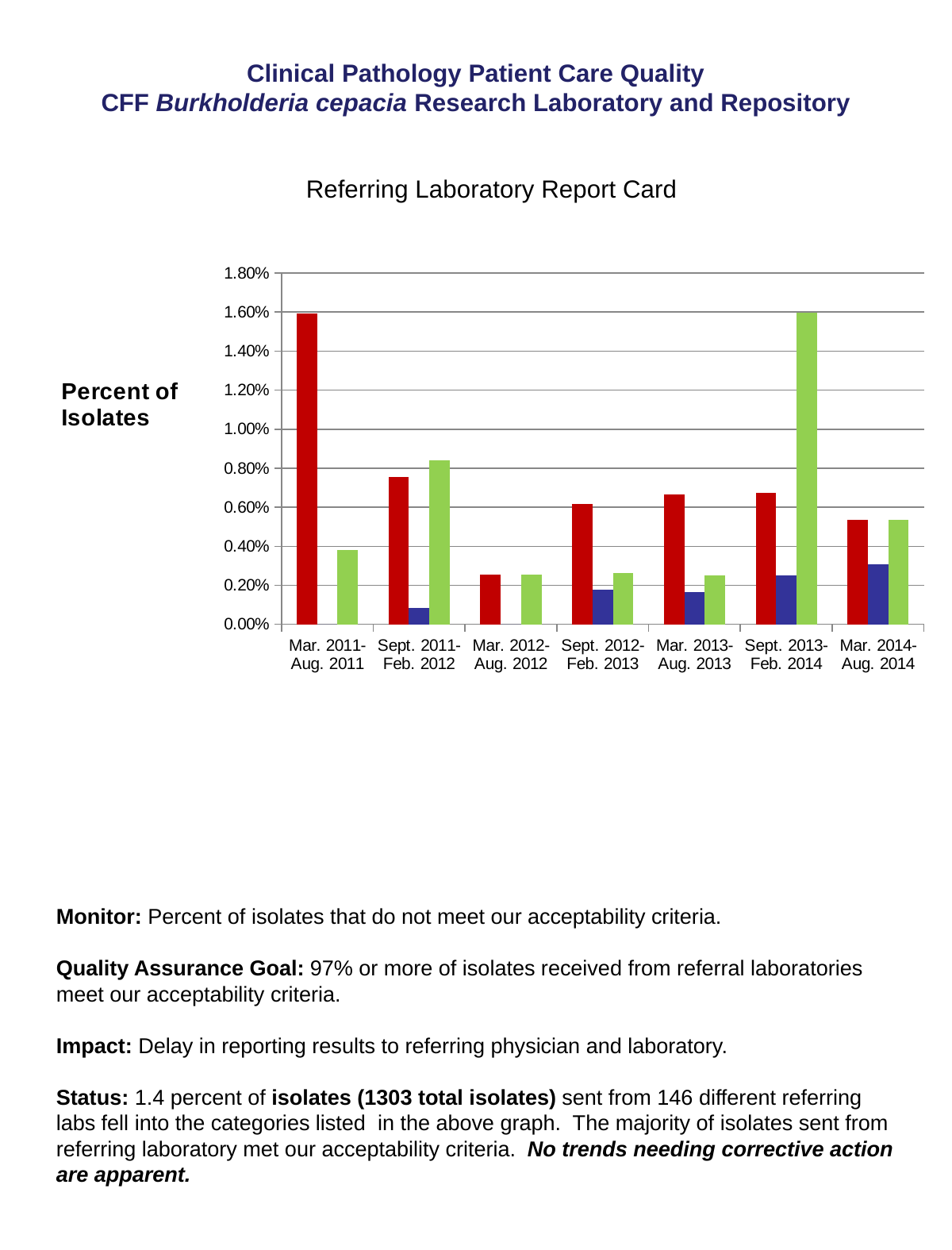
What is the title of the chart? Referring Laboratory Report Card Is the value of the red bar for Sept. 2011-Feb. 2012 greater or less than 0.60%? greater Is the value of the red bar for Mar. 2011-Aug. 2011 greater or less than 1.40%? greater Is the value of the green bar for Sept. 2013-Feb. 2014 greater or less than 1.40%? greater How many time periods are shown along the x axis of the chart? 7 In which period is the red bar the tallest? Mar. 2011-Aug. 2011 In which period is the red bar the shortest? Mar. 2012-Aug. 2012 What is the label on the vertical axis of the chart? Percent of Isolates What kind of chart is shown on the slide? bar chart For Sept. 2011-Feb. 2012, which bar is taller, the red bar or the green bar? green bar In which period is the green bar the tallest? Sept. 2013-Feb. 2014